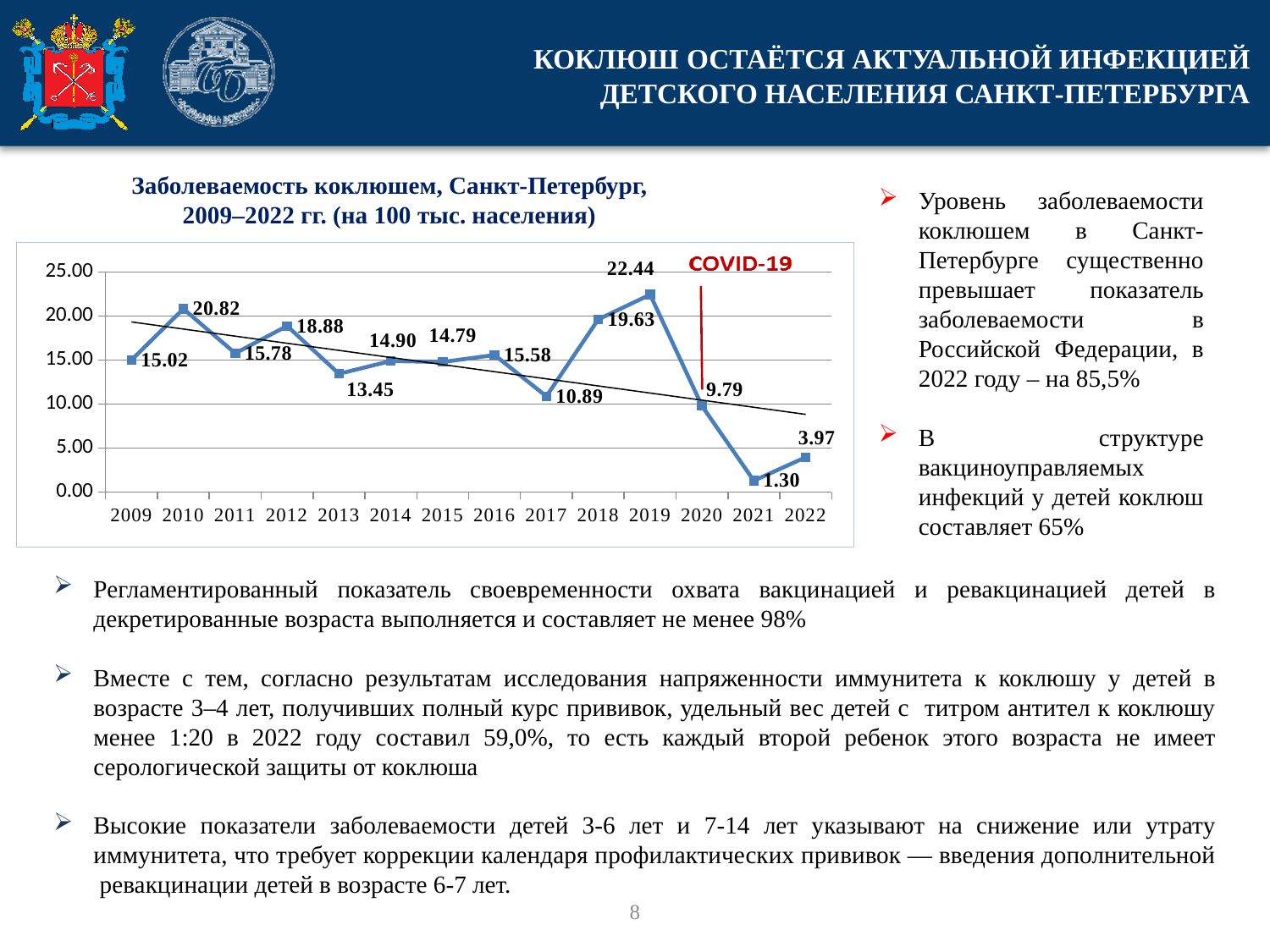
Which year has the lowest pertussis incidence? 2021 Which year has the highest pertussis incidence? 2019 What is the pertussis incidence value for 2013? 13.45 What is the difference between the 2022 and 2021 values? 2.67 How many years (data points) are plotted on the chart? 14 What type of chart is shown on the slide? Line chart What is the pertussis incidence value for 2021? 1.30 Does the trend line on the chart rise or fall from 2009 to 2022? Falls What is the difference between the 2019 and 2020 values? 12.65 What is the pertussis incidence value for 2019? 22.44 Which year has a higher value, 2010 or 2018? 2010 Which year is marked with the red COVID-19 annotation line? 2020